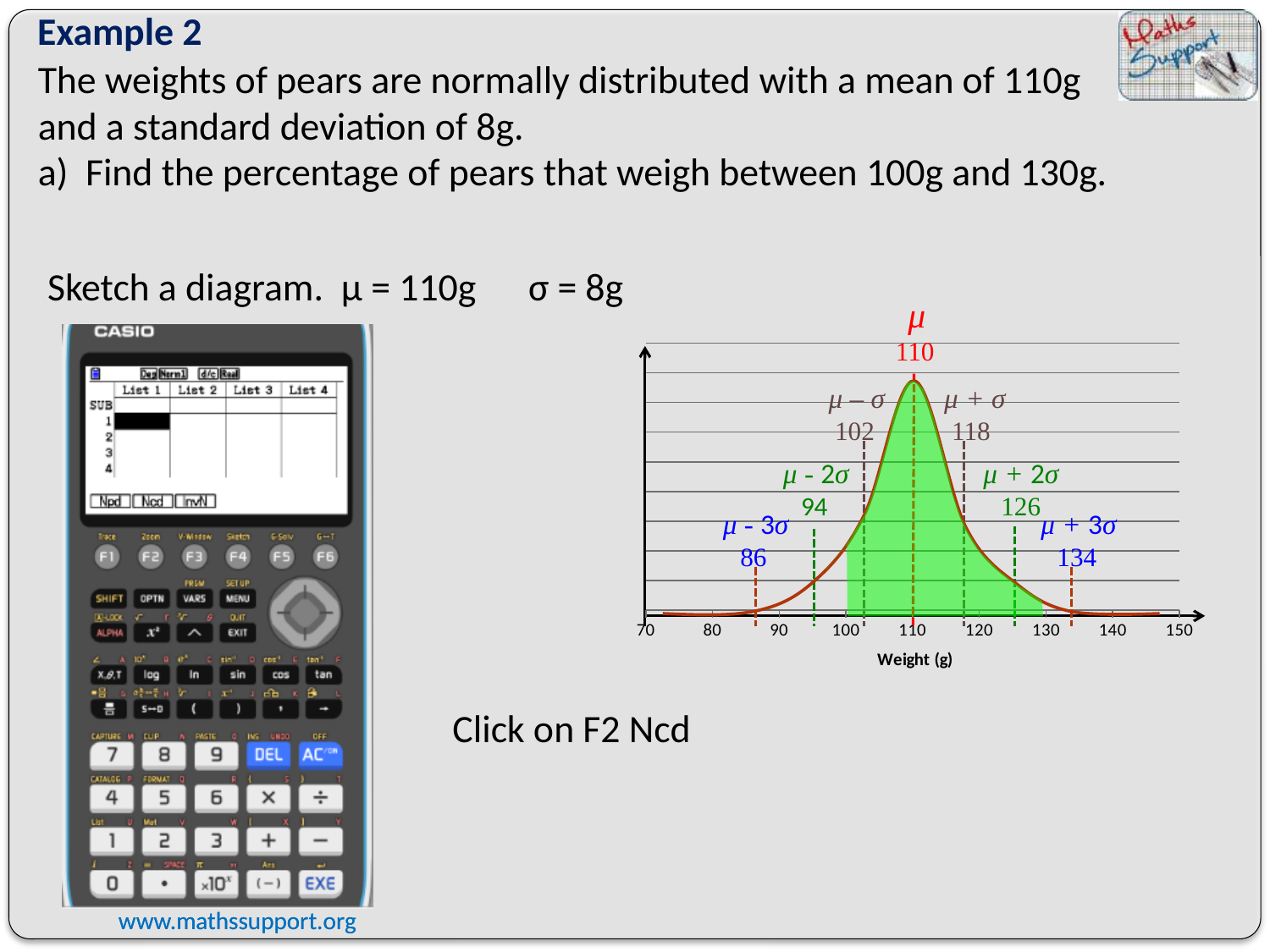
What is the highest value shown on the x-axis of the chart? 150 What is the x-axis title of the chart? Weight (g) What value is labelled at μ - 3σ on the chart? 86 What value is marked at the mean μ on the chart? 110 What value is labelled at μ + 2σ on the chart? 126 What value is labelled at μ + 3σ on the chart? 134 What is the difference between the values labelled at μ + 3σ and μ - 3σ on the chart? 48 What value is labelled at μ – σ on the chart? 102 What value is labelled at μ - 2σ on the chart? 94 What is the lowest value shown on the x-axis of the chart? 70 What value is labelled at μ + σ on the chart? 118 Between which two x-axis values is the green shaded region of the chart? 100 and 130